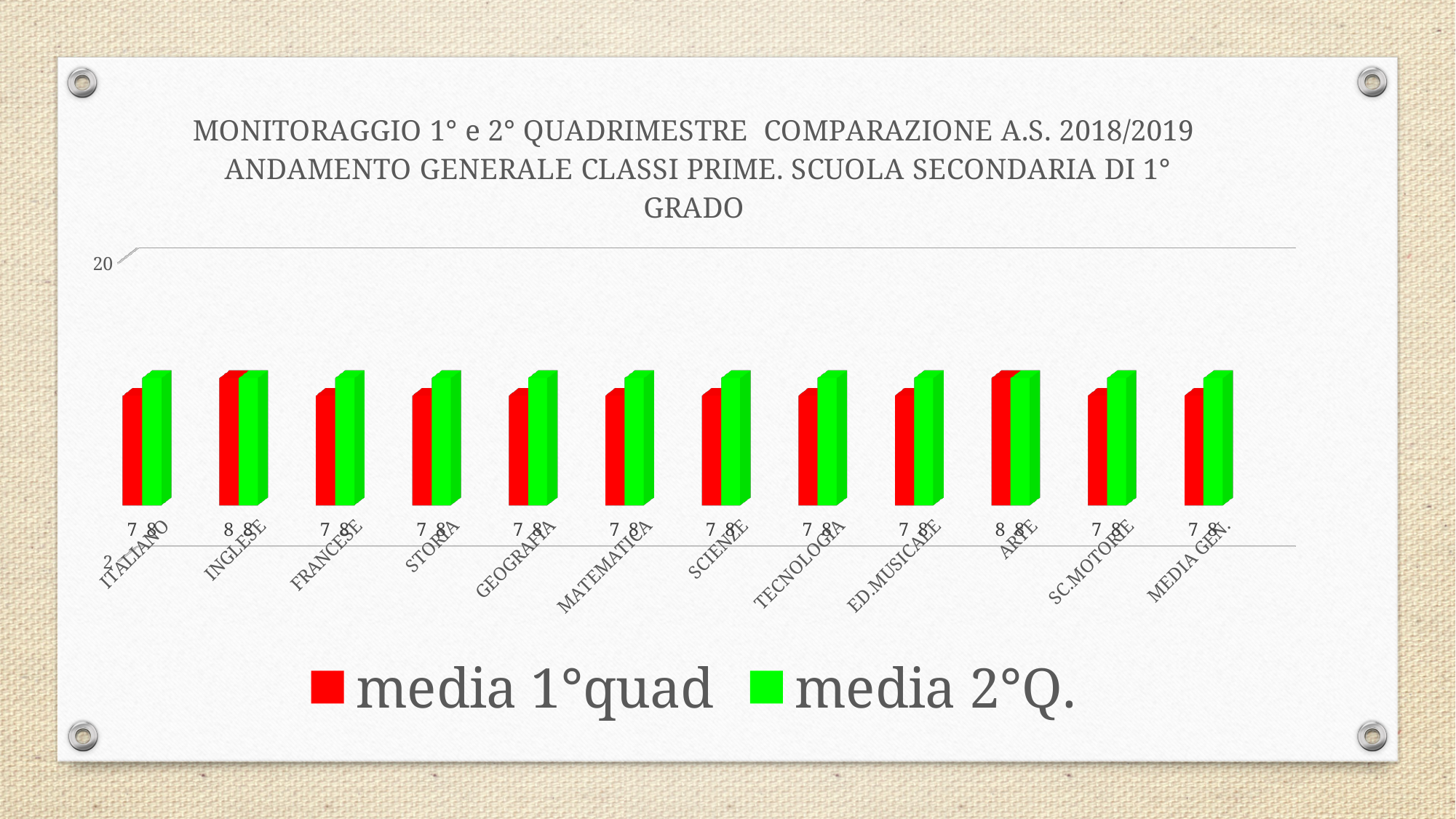
What is the value of media 2°Q. for MATEMATICA? 8 Which colour represents the media 1°quad series? Red Is the value of media 2°Q. for SCIENZE greater or less than 20? less What is the value of media 1°quad for ARTE? 8 What is the difference between media 2°Q. and media 1°quad for STORIA? 1 What is the value of media 1°quad for INGLESE? 8 What kind of chart is shown on the slide? Bar chart What is the value of media 1°quad for ITALIANO? 7 What is the value of media 2°Q. for MEDIA GEN.? 8 How many series does the legend list? 2 How many categories are shown on the x axis? 12 For FRANCESE, which is larger: media 1°quad or media 2°Q.? media 2°Q.